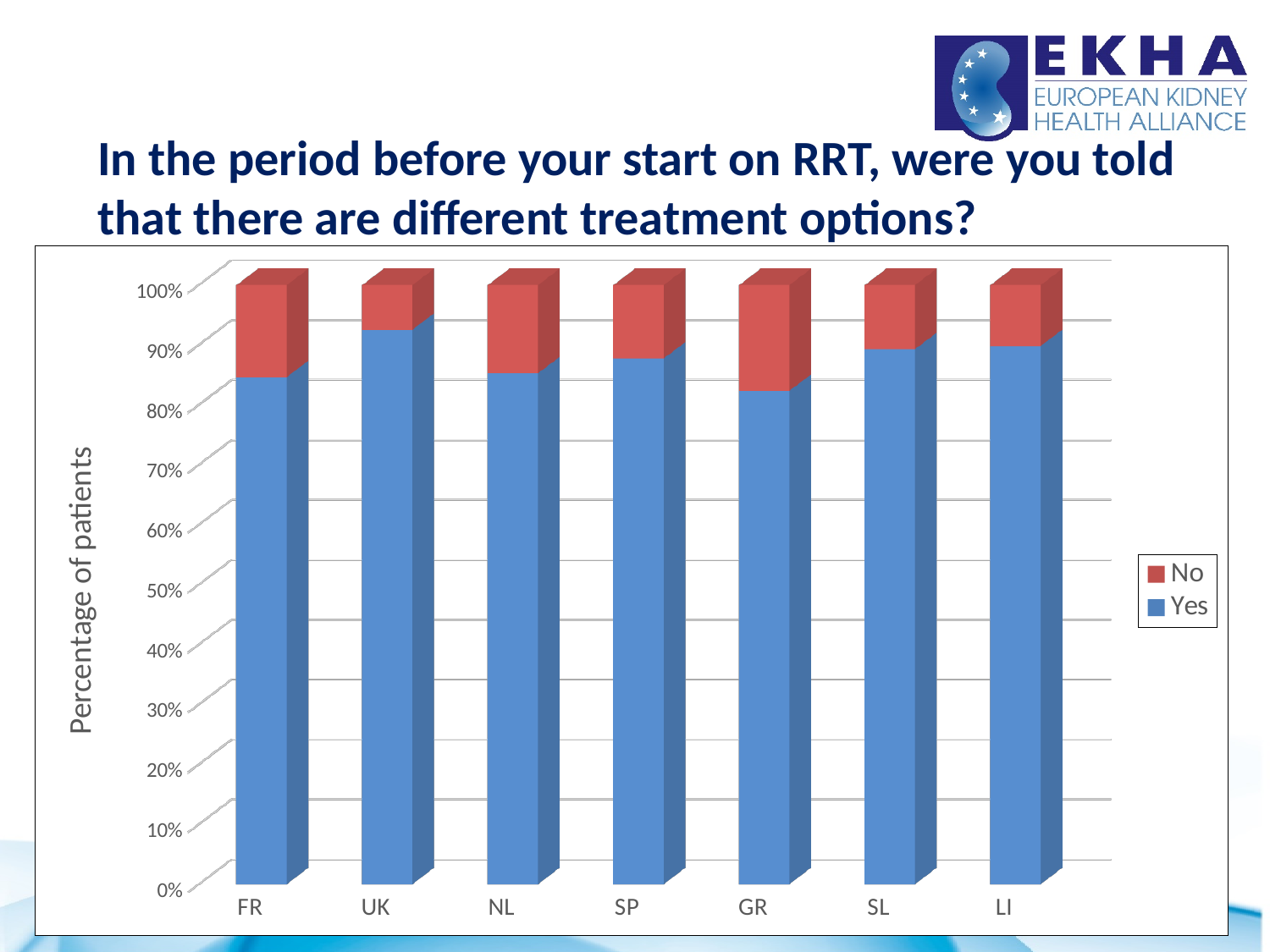
How many countries are shown on the x axis of the chart? 7 Is the Yes share for FR greater or less than 80%? greater Is the Yes share for UK greater or less than 90%? greater Which country has the largest share of patients answering No? GR Which country has the lowest share of patients answering Yes? GR Is the Yes share for UK larger or smaller than the Yes share for GR? larger What kind of chart is shown on the slide? Stacked bar chart Is the Yes share for GR greater or less than 90%? less How many series does the chart's legend list? 2 Which country has the highest share of patients answering Yes? UK What is the label of the vertical axis? Percentage of patients Which colour represents the No responses in the chart? Red